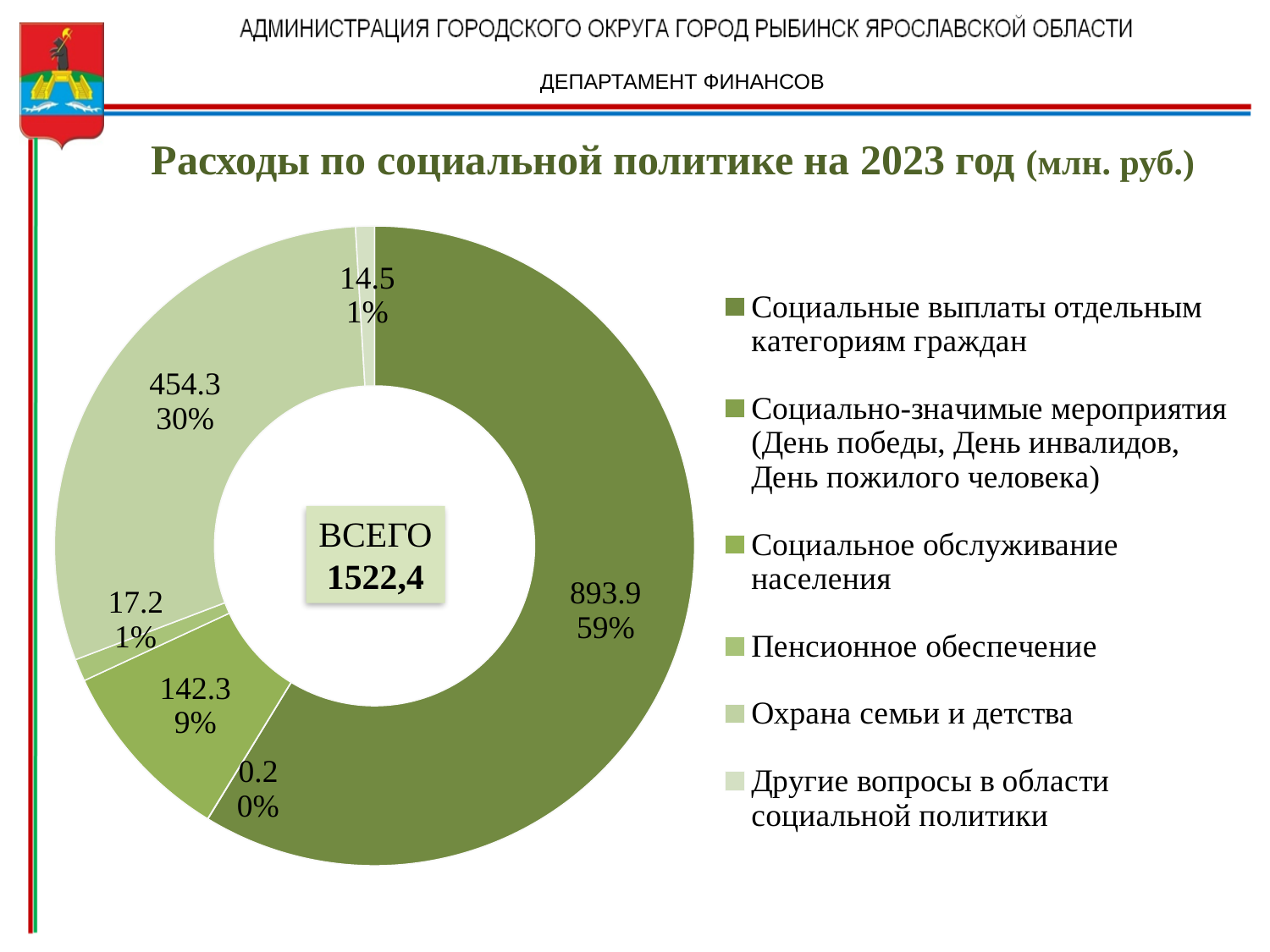
What kind of chart is shown on the slide? Pie (donut) chart What is the value for Пенсионное обеспечение? 17.2 What is the difference between the values for Социальные выплаты отдельным категориям граждан and Охрана семьи и детства? 439.6 What is the value for Социальное обслуживание населения? 142.3 What share of the pie does Охрана семьи и детства take? 30% Which category has the highest value? Социальные выплаты отдельным категориям граждан What is the value for Социальные выплаты отдельным категориям граждан? 893.9 How many categories does the legend list? 6 What share of the pie does Социальные выплаты отдельным категориям граждан take? 59% Which category has the lowest value? Социально-значимые мероприятия (День победы, День инвалидов, День пожилого человека) What total (ВСЕГО) is shown in the centre of the chart? 1522,4 Which is larger: Социальное обслуживание населения or Другие вопросы в области социальной политики? Социальное обслуживание населения